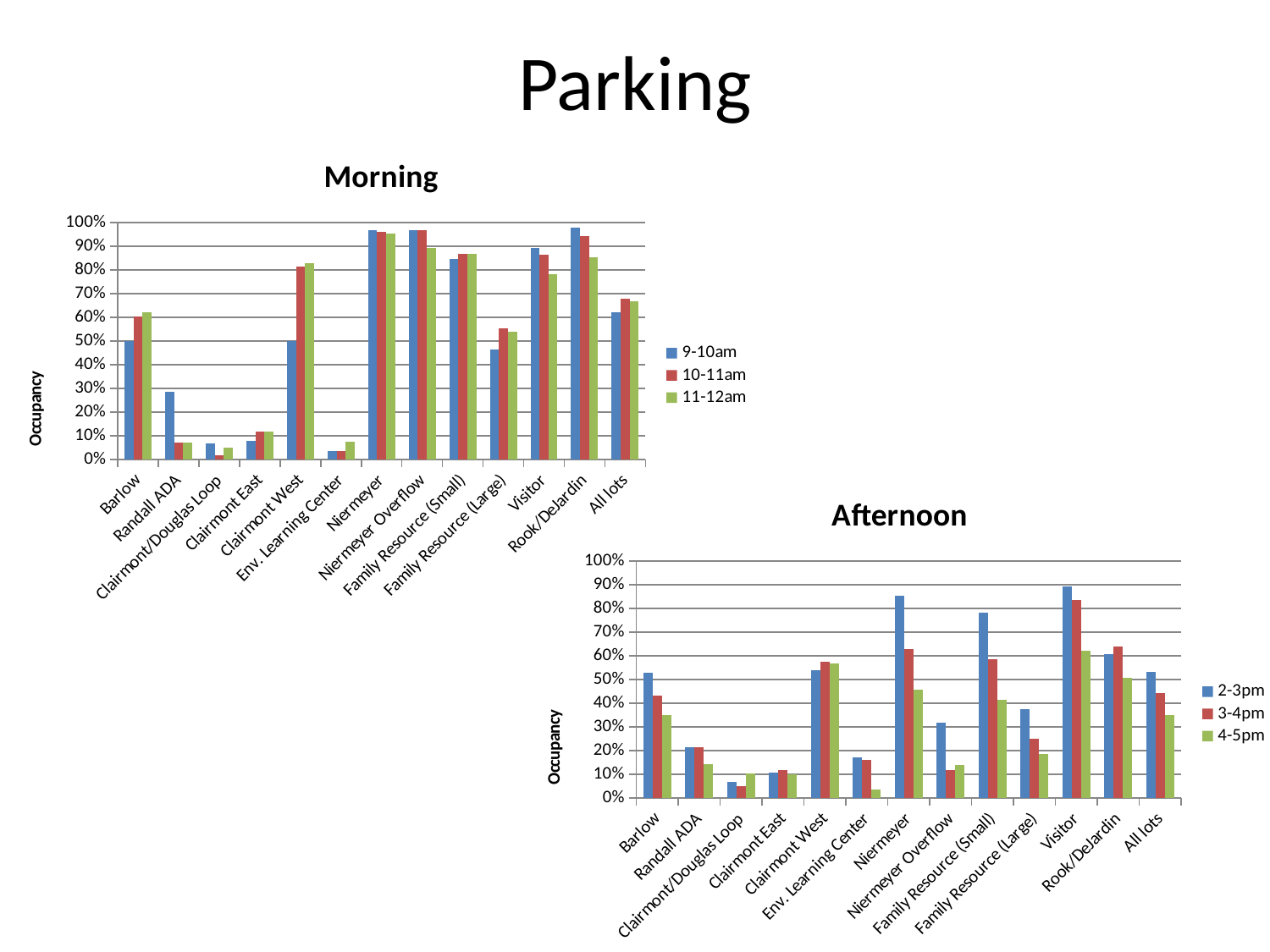
In the Afternoon chart, is the 2-3pm value for Niermeyer greater or less than 80%? greater In the Afternoon chart, is the 4-5pm value for All lots greater or less than 40%? less What type of chart is the Morning chart? bar chart In the Morning chart, is the 9-10am value for Family Resource (Large) greater or less than 50%? less In the Afternoon chart, do the values for Niermeyer rise or fall from 2-3pm to 4-5pm? fall In the Afternoon chart, which is larger for Barlow: the 2-3pm value or the 4-5pm value? 2-3pm What is the label on the vertical axis of the Morning chart? Occupancy In the Morning chart, which category has the lowest 10-11am value? Clairmont/Douglas Loop How many parking lot categories are shown on the x axis of the Morning chart? 13 In the Afternoon chart, which category has the lowest 4-5pm value? Env. Learning Center How many series does the legend of the Afternoon chart list? 3